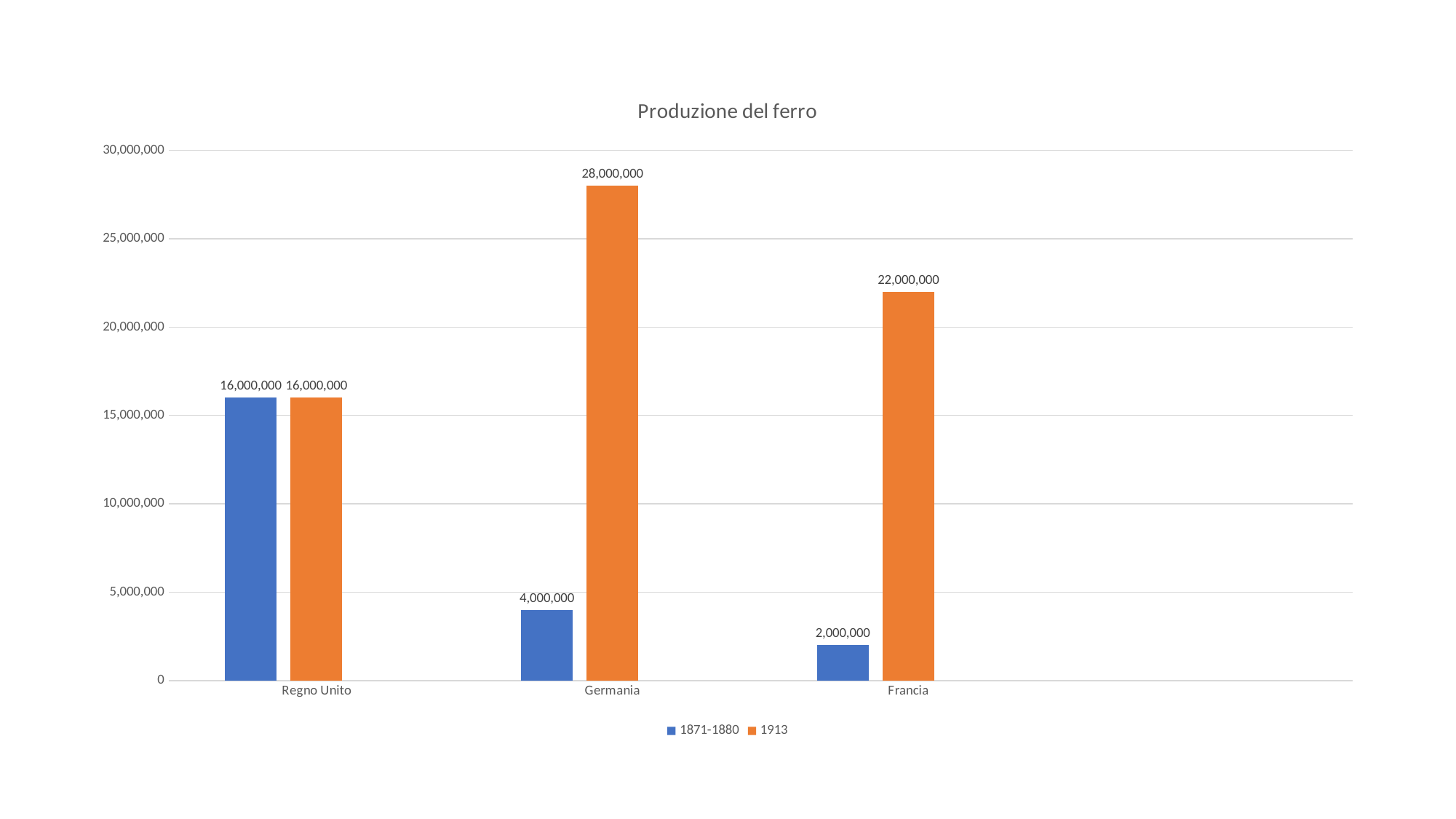
Is the 1913 value for Francia greater or less than 20,000,000? greater What is the title of the chart? Produzione del ferro What is the value for Francia in the 1871-1880 series? 2,000,000 How many categories are shown on the x axis? 3 Which is larger: the 1913 value for Francia or the 1913 value for Regno Unito? Francia How many series does the legend list? 2 Which category has the highest value in the 1913 series? Germania What kind of chart is shown on the slide? bar chart What is the difference between the 1913 and 1871-1880 values for Germania? 24,000,000 What is the value for Regno Unito in the 1913 series? 16,000,000 What is the value for Germania in the 1913 series? 28,000,000 Which category has the lowest value in the 1871-1880 series? Francia